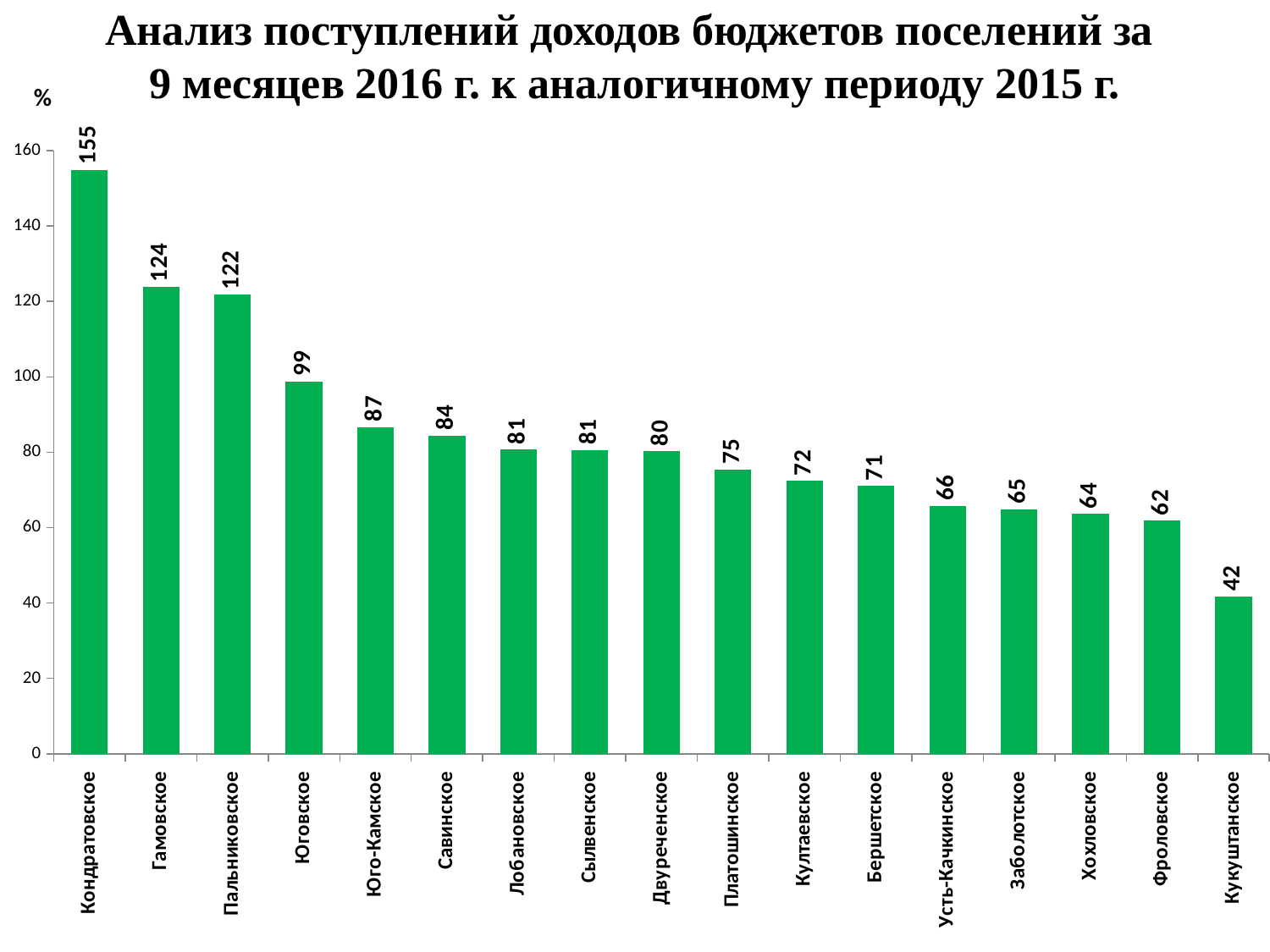
Is the value for Савинское greater or less than 100? less What is the value for Юговское? 99 Which category has the highest value? Кондратовское Which category has the lowest value? Кукуштанское What is the difference between the values for Гамовское and Пальниковское? 2 What is the value for Усть-Качкинское? 66 What kind of chart is shown on the slide? bar chart What is the difference between the values for Кондратовское and Кукуштанское? 113 What is the value for Кондратовское? 155 Do the values rise or fall from left to right along the x axis? fall Which is larger, the value for Юго-Камское or the value for Платошинское? Юго-Камское How many categories are shown on the x axis? 17